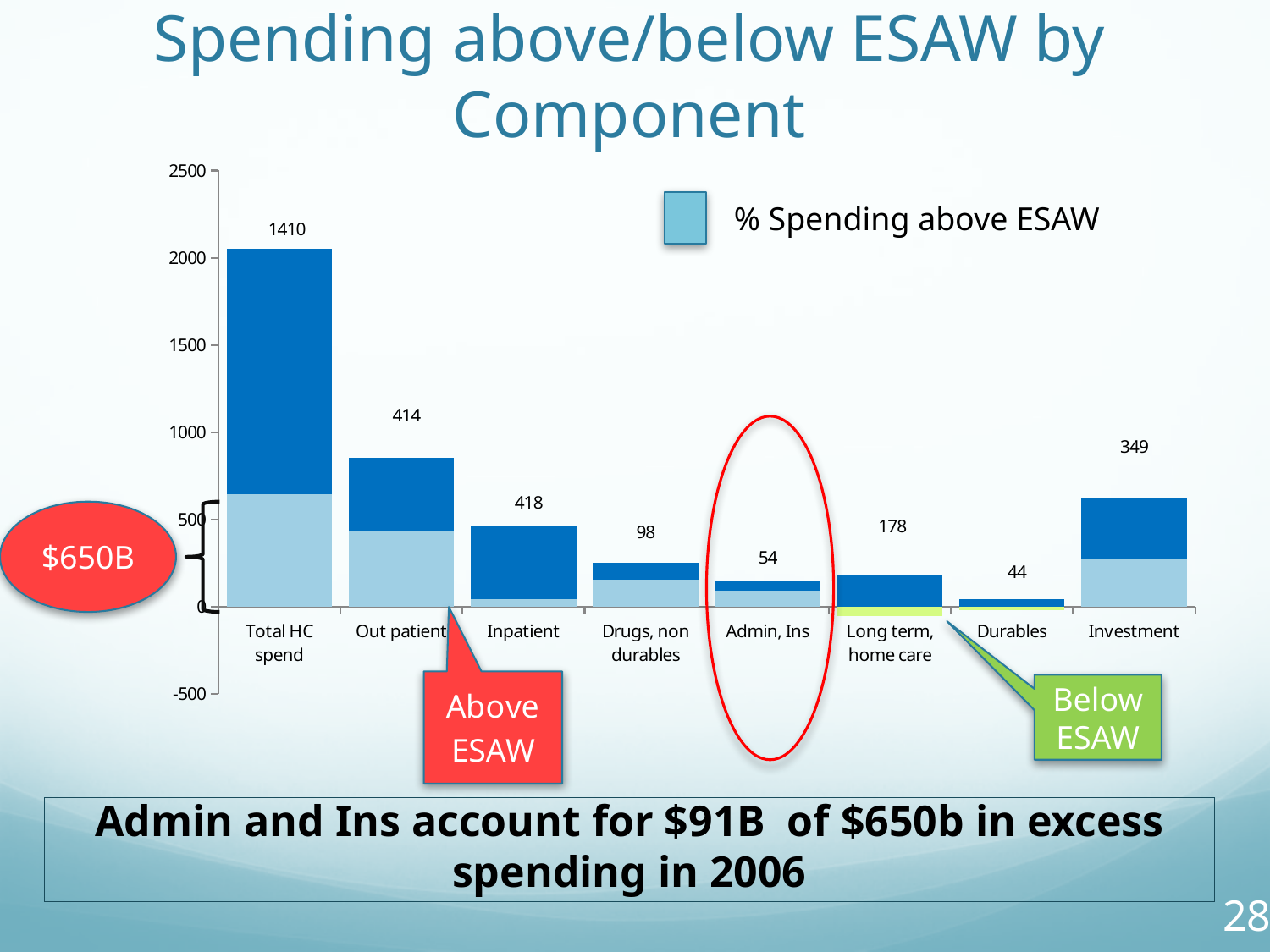
Which category has the highest data label? Total HC spend What is the data label shown for Admin, Ins? 54 What is the title of the chart? Spending above/below ESAW by Component Is the top of the Total HC spend bar greater or less than 2000? greater What is the data label shown for Total HC spend? 1410 What is the data label shown for Long term, home care? 178 Which category has the lowest data label? Durables Which has the larger data label, Investment or Long term, home care? Investment How many categories are shown on the x axis? 8 What is the data label shown for Investment? 349 What kind of chart is shown on the slide? Bar chart What is the difference between the data labels for Total HC spend and Out patient? 996